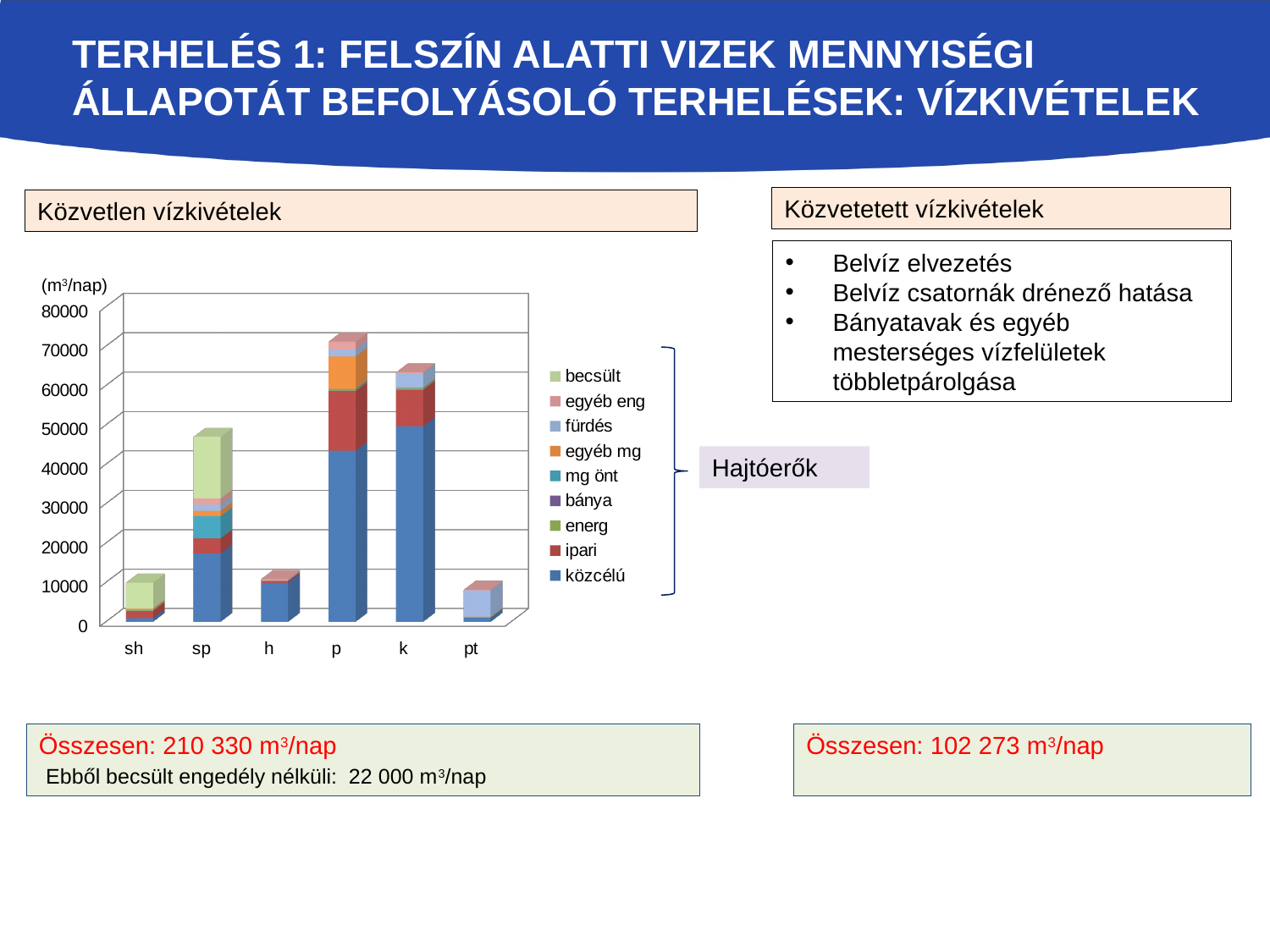
Is the total value for p greater or less than 60000? greater How many categories are shown on the x axis of the chart? 6 Which category has the highest total bar in the chart? p Which is larger, the total bar for sp or the total bar for h? sp Which series is listed last in the chart legend? közcélú How many series does the chart legend list? 9 What kind of chart is shown on the slide? stacked bar chart Which is larger, the total bar for p or the total bar for k? p Is the total value for sp greater or less than 40000? greater Is the total value for h greater or less than 20000? less What unit is shown on the y axis of the chart? m³/nap